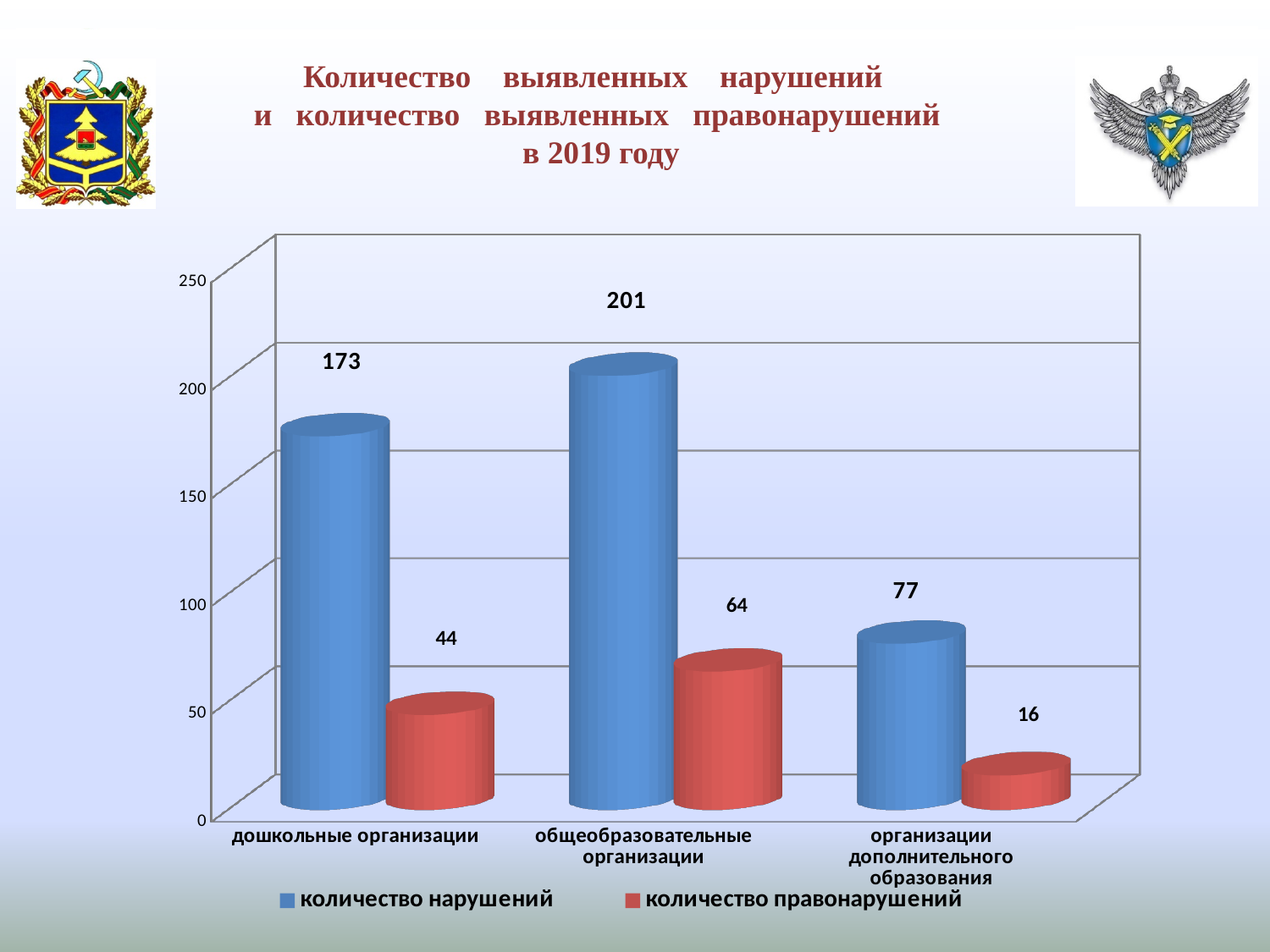
How many series does the legend list? 2 Which category has the lowest количество правонарушений? организации дополнительного образования Which is larger: количество правонарушений for общеобразовательные организации or for дошкольные организации? общеобразовательные организации What is the value of количество нарушений for организации дополнительного образования? 77 Which category has the highest количество нарушений? общеобразовательные организации What kind of chart is shown on the slide? bar chart What is the value of количество нарушений for общеобразовательные организации? 201 What is the difference between количество нарушений and количество правонарушений for дошкольные организации? 129 How many categories are shown on the x axis? 3 What is the value of количество правонарушений for дошкольные организации? 44 Is the value of количество нарушений for дошкольные организации greater or less than 150? greater Which colour represents количество правонарушений in the legend? red